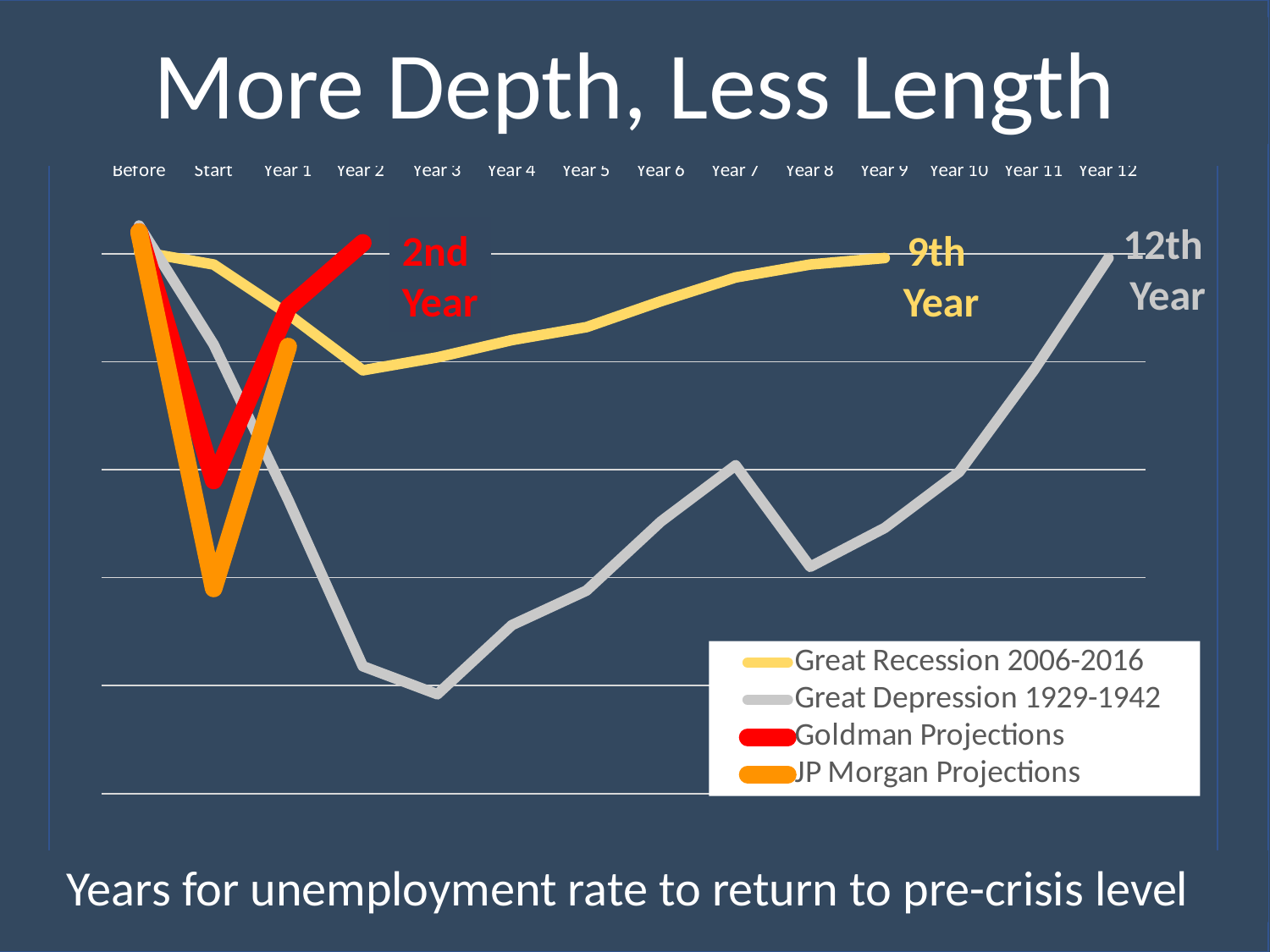
What kind of chart is shown on the slide? line chart At the Start category, which line dips lower: Goldman Projections or JP Morgan Projections? JP Morgan Projections Which series reaches the lowest point on the chart? Great Depression 1929-1942 Does the Great Recession 2006-2016 line rise or fall from Before to Year 2? fall According to the annotation, in which year does the Goldman Projections line return to the pre-crisis level? 2nd Year According to the annotation, in which year does the Great Recession 2006-2016 line return to the pre-crisis level? 9th Year According to the annotation, in which year does the Great Depression 1929-1942 line return to the pre-crisis level? 12th Year What is the title of the slide? More Depth, Less Length How many categories are shown along the x axis? 14 How many series does the legend list? 4 Does the Great Depression 1929-1942 line rise or fall from Year 3 to Year 7? rise Which series is drawn in grey? Great Depression 1929-1942